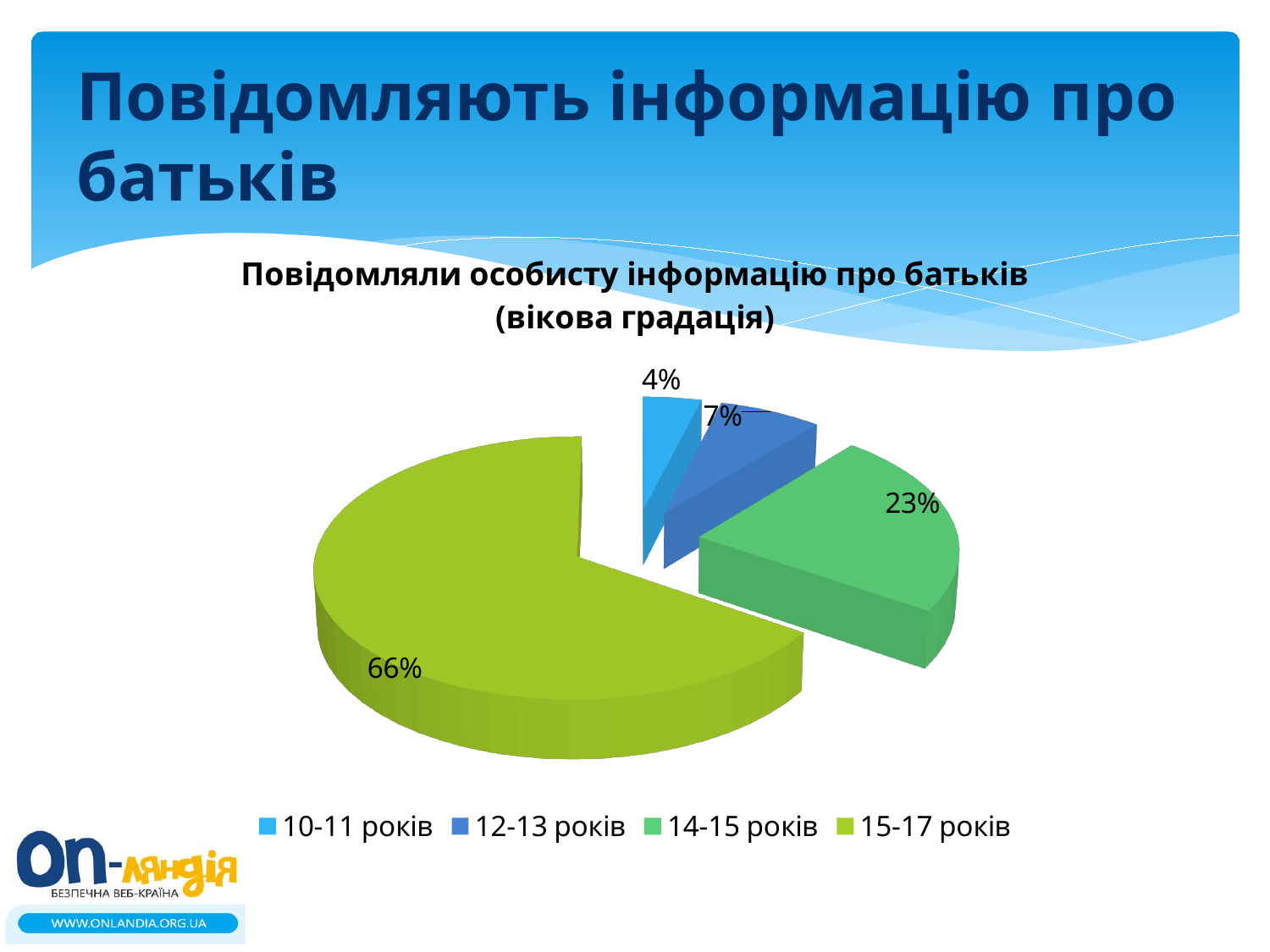
What share of the pie does the 15-17 років slice represent? 66% What share of the pie does the 12-13 років slice represent? 7% Which age group has the largest slice of the pie? 15-17 років What is the difference in percentage points between the 12-13 років slice and the 10-11 років slice? 3 What is the difference in percentage points between the 15-17 років slice and the 14-15 років slice? 43 Which slice is larger: 14-15 років or 12-13 років? 14-15 років What share of the pie does the 10-11 років slice represent? 4% How many slices does the pie chart have? 4 What is the title of the chart? Повідомляли особисту інформацію про батьків (вікова градація) What type of chart is shown on the slide? Pie chart What share of the pie does the 14-15 років slice represent? 23% Which age group has the smallest slice of the pie? 10-11 років